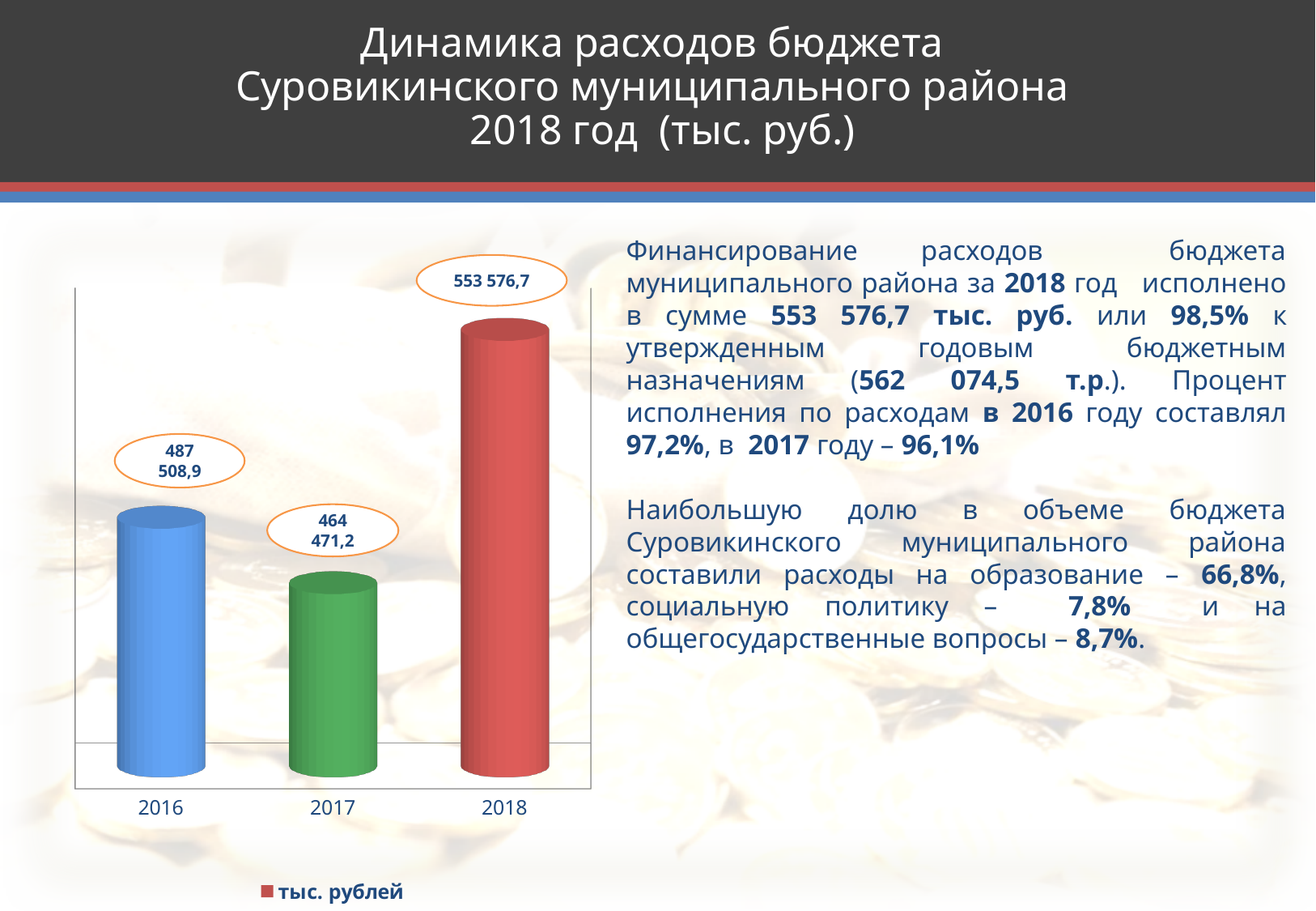
What is the value for 2018 on the chart? 553 576,7 What is the value for 2016 on the chart? 487 508,9 Which year has the highest value on the chart? 2018 What is the legend entry shown below the chart? тыс. рублей Which is larger, the value for 2016 or the value for 2017? 2016 What is the value for 2017 on the chart? 464 471,2 What is the difference between the values for 2018 and 2016? 66 067,8 How many years are shown on the chart? 3 What is the difference between the values for 2016 and 2017? 23 037,7 Which year has the lowest value on the chart? 2017 Does the value rise or fall from 2017 to 2018? Rise What kind of chart is shown on the slide? Bar chart